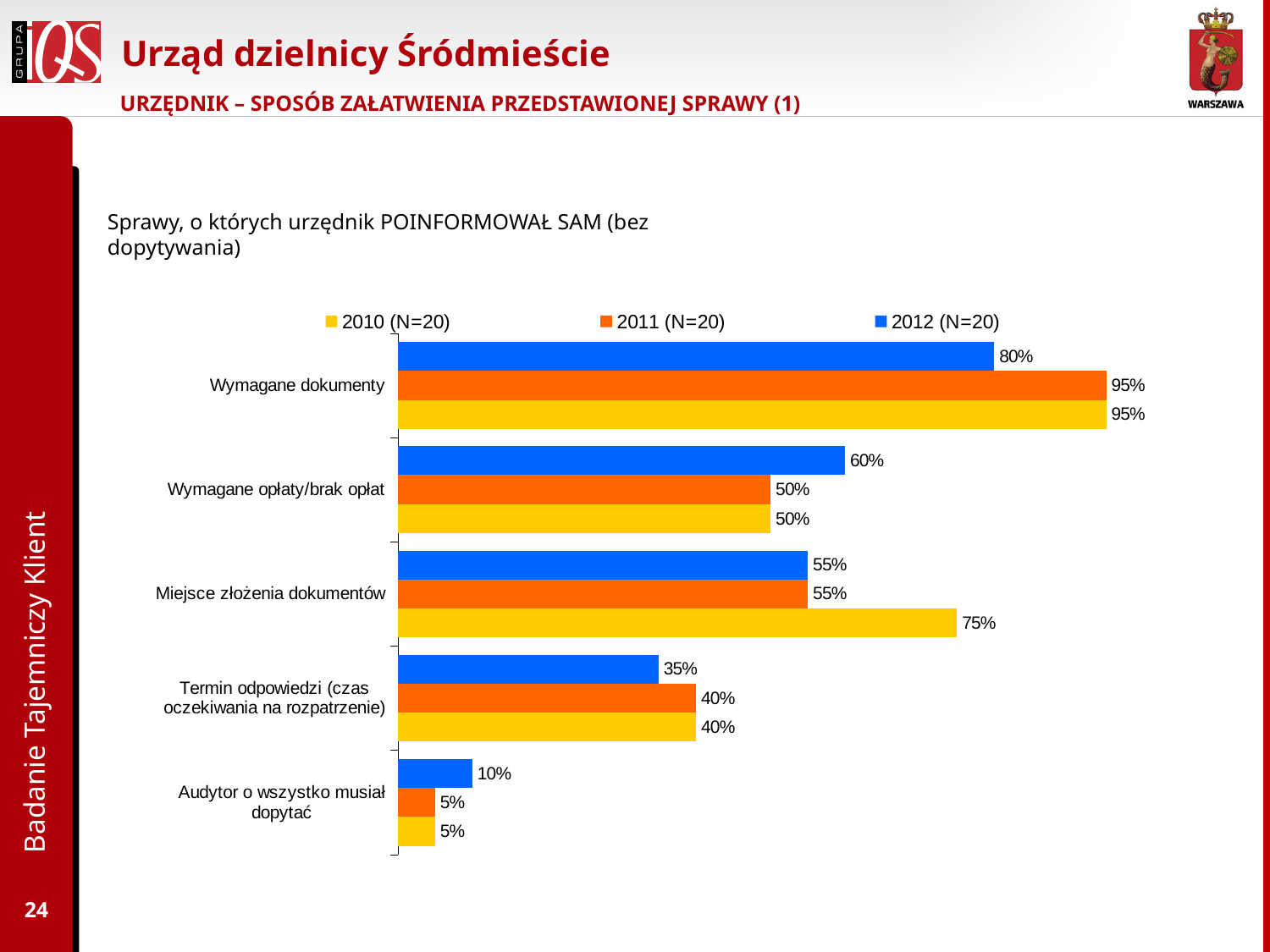
How many series does the legend list? 3 Which category has the lowest value in the 2010 (N=20) series? Audytor o wszystko musiał dopytać What is the difference between the 2010 (N=20) and 2012 (N=20) values for Wymagane dokumenty? 15% What kind of chart is shown on the slide? Bar chart What is the value for Termin odpowiedzi (czas oczekiwania na rozpatrzenie) in the 2012 (N=20) series? 35% Which is larger for Miejsce złożenia dokumentów: the 2010 (N=20) value or the 2012 (N=20) value? 2010 (N=20) Which category has the highest value in the 2012 (N=20) series? Wymagane dokumenty What is the value for Wymagane dokumenty in the 2012 (N=20) series? 80% Which colour represents the 2011 (N=20) series in the legend? Orange What is the value for Miejsce złożenia dokumentów in the 2010 (N=20) series? 75% What is the value for Wymagane opłaty/brak opłat in the 2011 (N=20) series? 50% How many categories are shown on the chart? 5